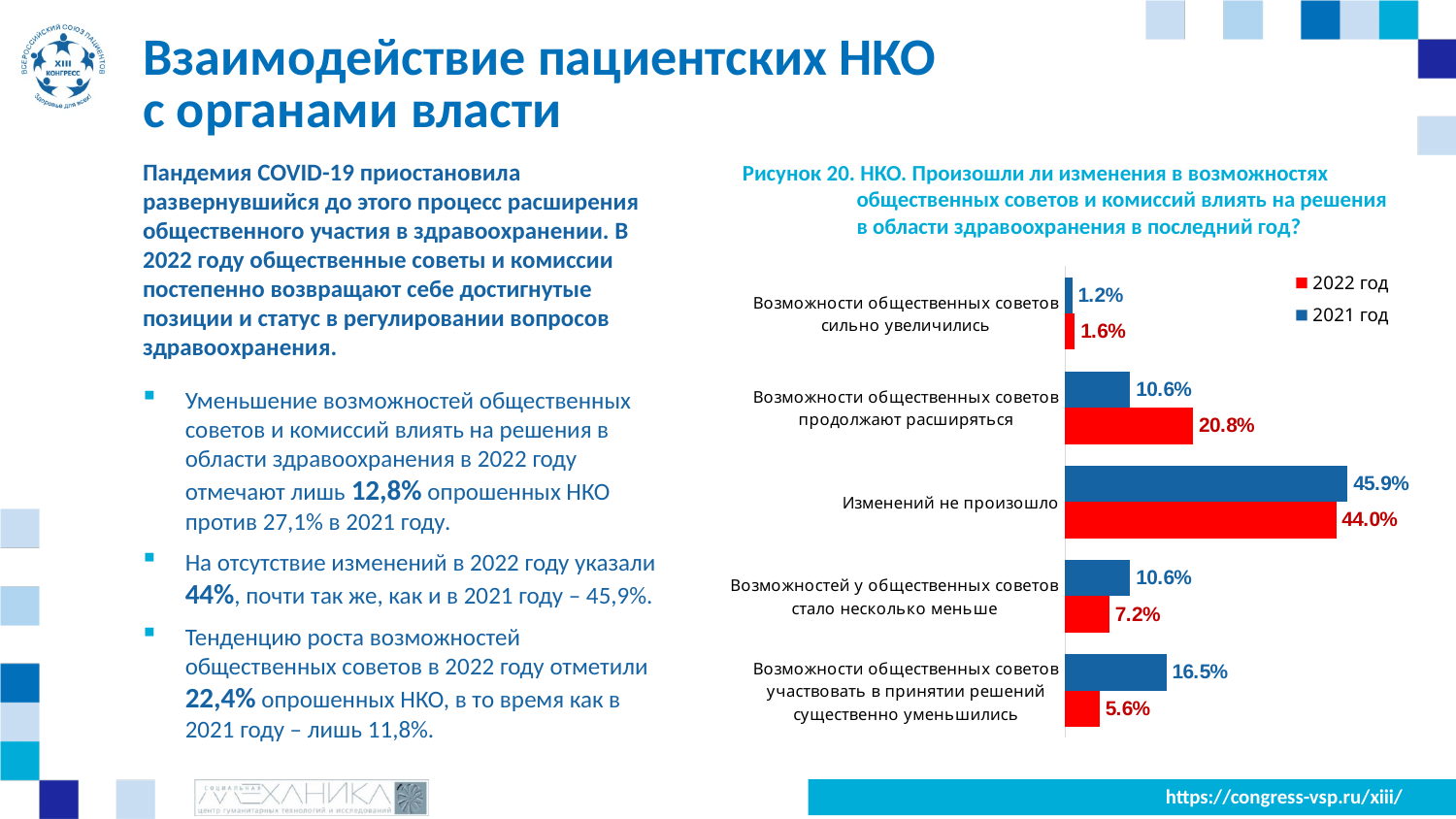
What is the difference between the 2022 год and 2021 год values for "Возможности общественных советов продолжают расширяться"? 10.2% What is the value for "Изменений не произошло" in the 2022 год series? 44.0% What is the difference between the 2021 год and 2022 год values for "Возможности общественных советов участвовать в принятии решений существенно уменьшились"? 10.9% What is the value for "Возможности общественных советов продолжают расширяться" in the 2021 год series? 10.6% What is the value for "Возможности общественных советов участвовать в принятии решений существенно уменьшились" in the 2022 год series? 5.6% Which category has the highest value in the 2021 год series? Изменений не произошло Which colour represents the 2022 год series in the chart? red What type of chart is shown on the slide? bar chart How many series does the chart legend list? 2 For "Возможностей у общественных советов стало несколько меньше", which series has the larger value, 2021 год or 2022 год? 2021 год How many categories are shown in the chart? 5 Which category has the lowest value in the 2022 год series? Возможности общественных советов сильно увеличились